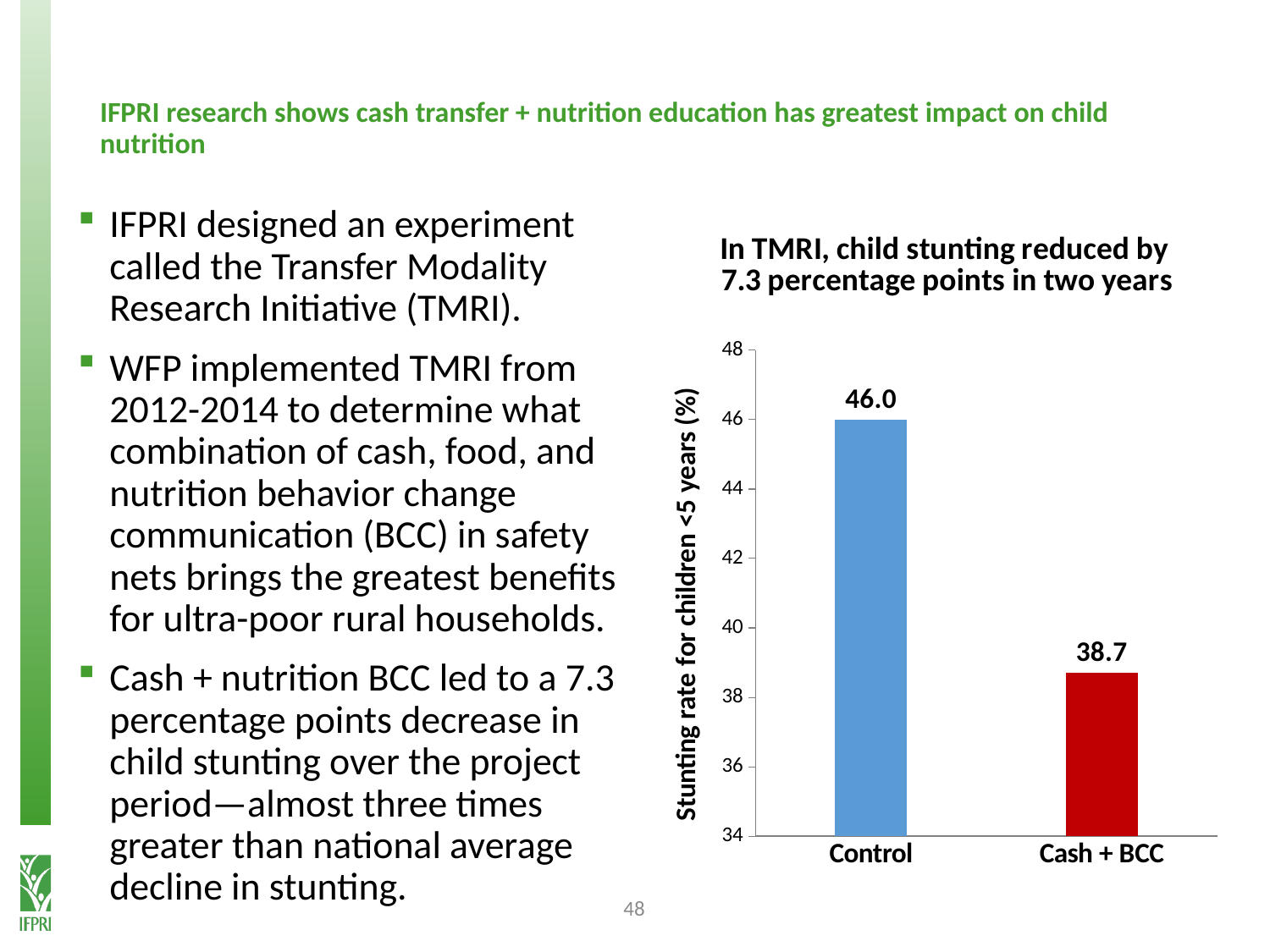
What kind of chart is shown on the slide? bar chart What is the label of the vertical axis? Stunting rate for children <5 years (%) Which is larger, the stunting rate for Control or for Cash + BCC? Control Is the value for Cash + BCC greater or less than 40? less What is the stunting rate for the Cash + BCC group? 38.7 Which category has the highest stunting rate? Control What is the difference in stunting rate between Control and Cash + BCC? 7.3 What is the stunting rate for the Control group? 46.0 Is the value for Control greater or less than 44? greater What is the title of the chart? In TMRI, child stunting reduced by 7.3 percentage points in two years How many categories are shown on the chart? 2 Which category has the lowest stunting rate? Cash + BCC